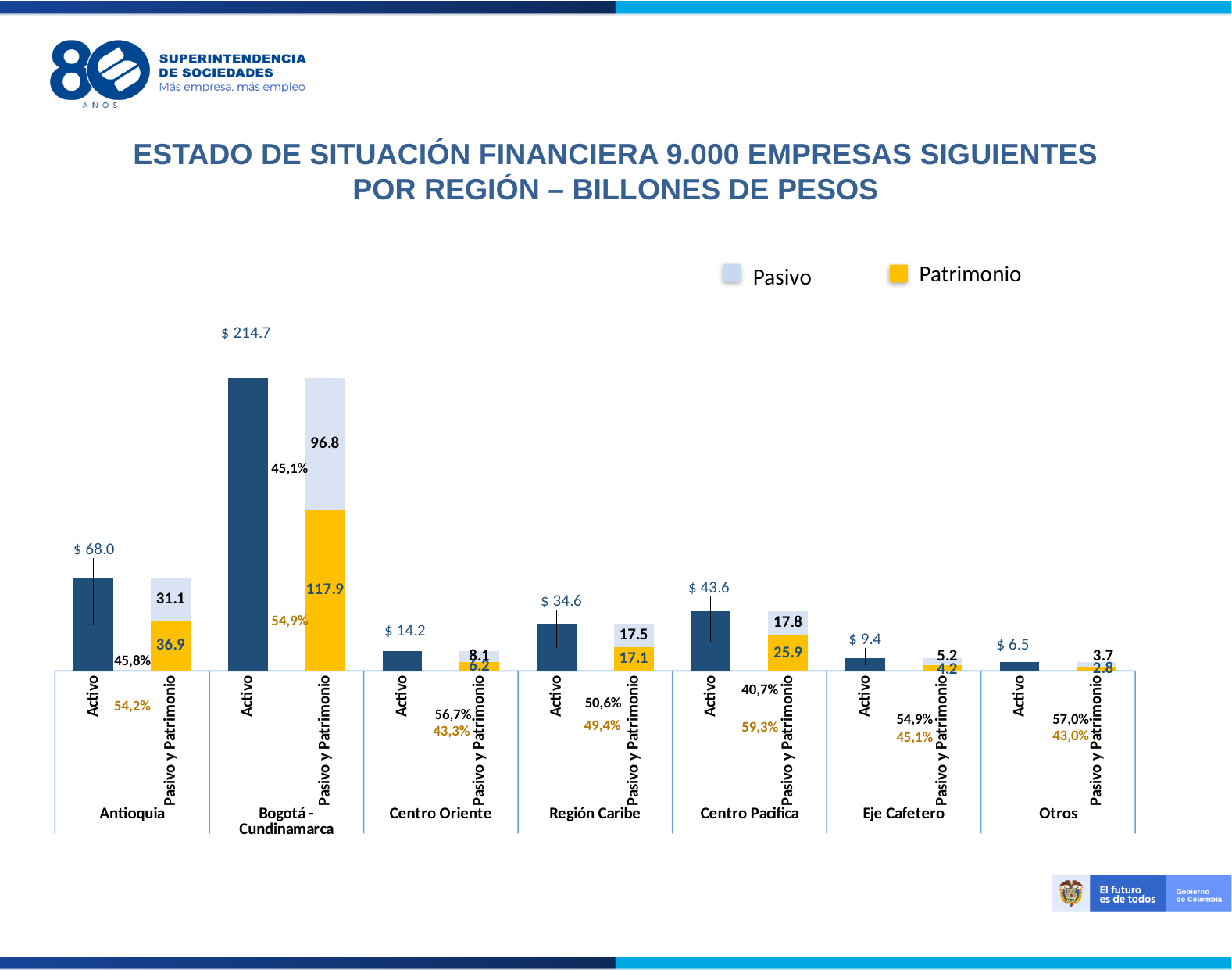
Which region has the lowest Activo value? Otros What kind of chart is shown on the slide? Bar chart Which region has the highest Activo value? Bogotá - Cundinamarca What is the Pasivo value for Centro Pacifica? 17.8 What is the difference between the Activo values of Antioquia and Centro Pacifica? 24.4 What is the total of the Pasivo y Patrimonio stacked bar for Eje Cafetero? 9.4 How many regions are shown on the chart? 7 What is the Activo value for Bogotá - Cundinamarca? $ 214.7 How many series does the legend list? 2 Which is larger for Región Caribe, Pasivo or Patrimonio? Pasivo What is the Patrimonio value for Antioquia? 36.9 What percentage is shown for Patrimonio in Centro Pacifica? 59,3%